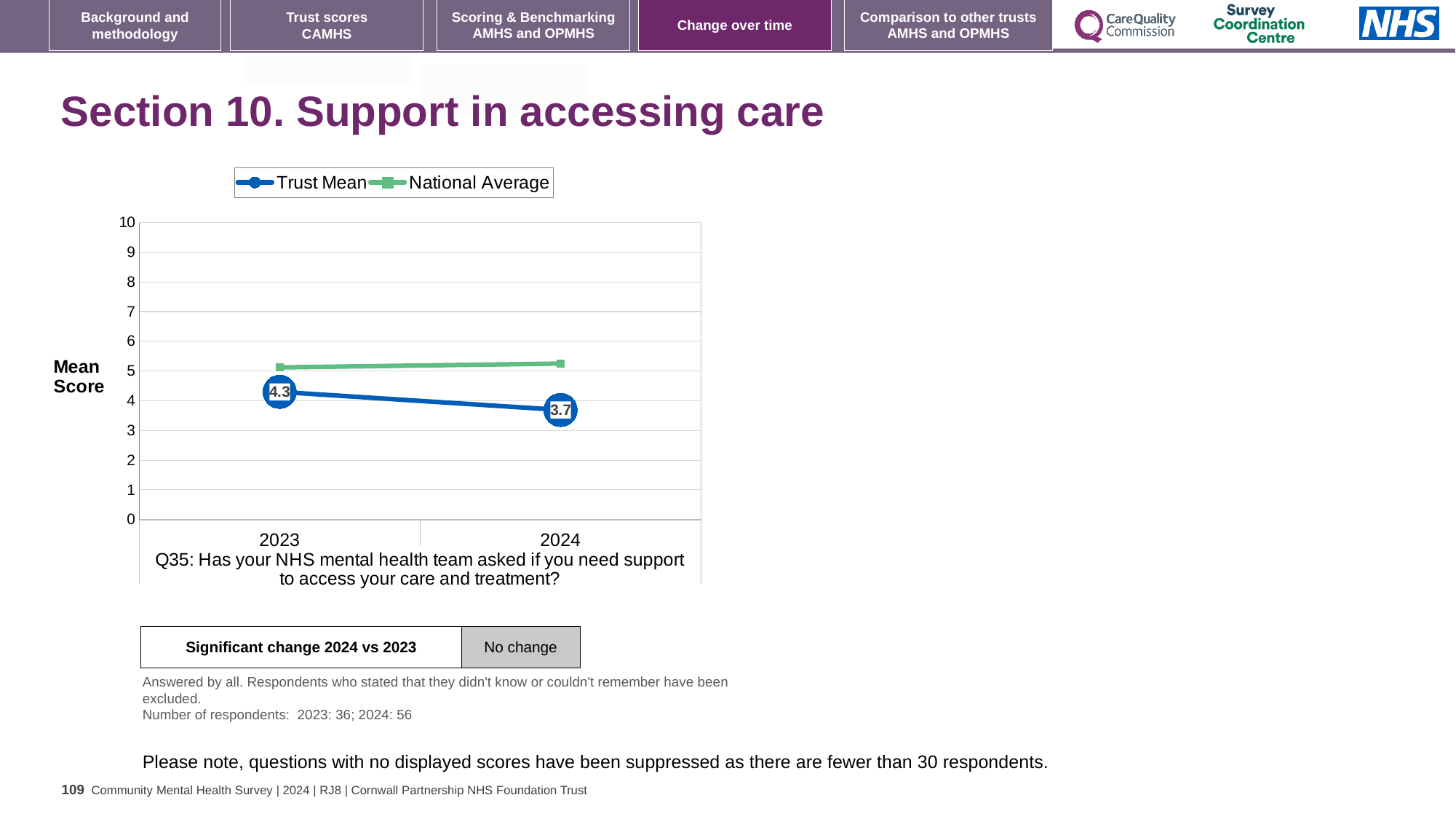
How many series does the legend list? 2 Does the Trust Mean rise or fall from 2023 to 2024? fall Is the National Average value for 2023 greater or less than 4? greater How many years are plotted on the x axis? 2 In 2024, which is larger: the Trust Mean or the National Average? National Average In which year is the Trust Mean highest? 2023 What is the Trust Mean value for 2023? 4.3 What kind of chart is shown on the slide? line chart In which year is the Trust Mean lowest? 2024 What is the Trust Mean value for 2024? 3.7 What is the difference between the Trust Mean in 2023 and in 2024? 0.6 Is the National Average value for 2024 greater or less than 6? less